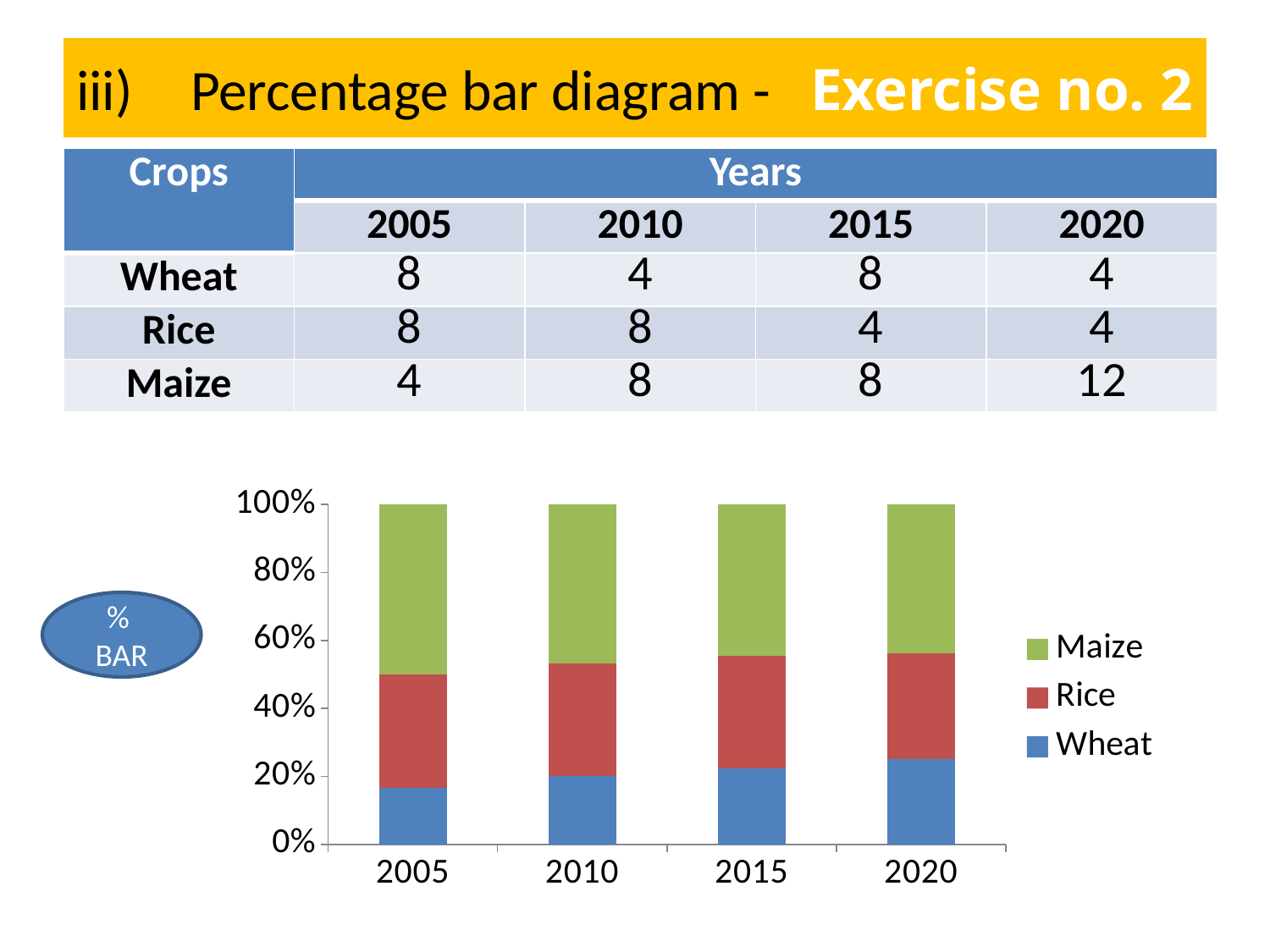
How many series does the chart legend list? 3 Is the Maize share of the 2005 bar greater or less than 40%? greater Is the Wheat share of the 2020 bar greater or less than 20%? greater Is the top of the Rice segment in the 2010 bar above or below 60%? below Is the Wheat share larger in 2005 or in 2020? 2020 Which crops are listed in the chart legend? Maize, Rice, Wheat What kind of chart is shown on the slide? Stacked bar chart What is the total height of each stacked bar in the chart? 100% Does the Wheat share rise or fall from 2005 to 2020 in the chart? rise How many years are shown along the x axis of the chart? 4 Which crop is shown in blue at the bottom of each bar? Wheat